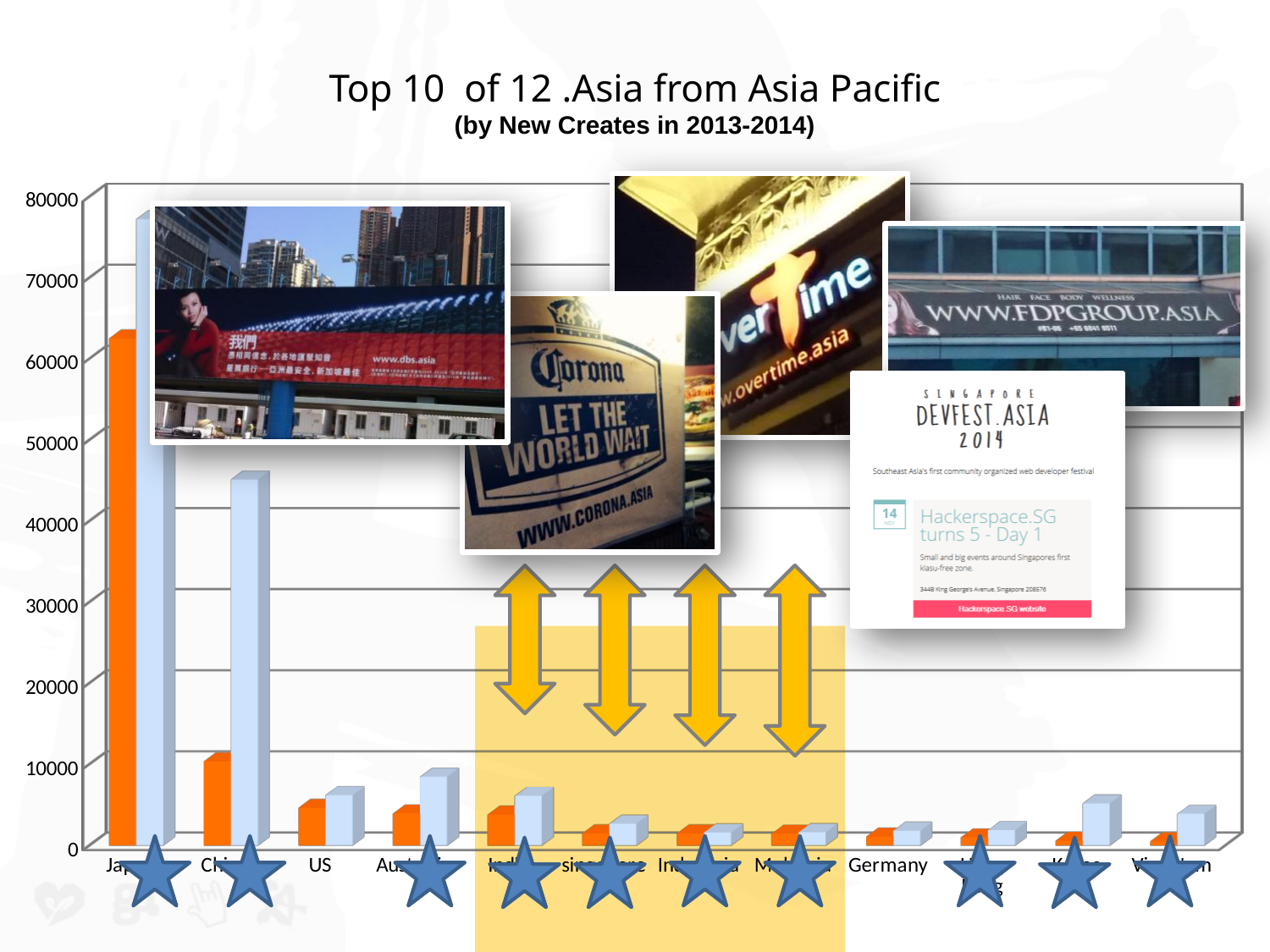
Do the orange bars generally rise or fall from the leftmost category to Germany? fall Which has the larger orange bar, US or Germany? US What is the title of the chart on the slide? Top 10 of 12 .Asia from Asia Pacific Is the orange bar for US greater or less than 10000? less What is the highest value shown on the vertical axis of the chart? 80000 Is the light blue bar for Germany greater or less than 10000? less What kind of chart is shown on the slide? bar chart What is the subtitle shown under the chart title? (by New Creates in 2013-2014) Is the light blue bar for the leftmost category greater or less than 70000? greater Which category has the tallest bars in the chart? the leftmost category How many categories are plotted along the x axis of the chart? 12